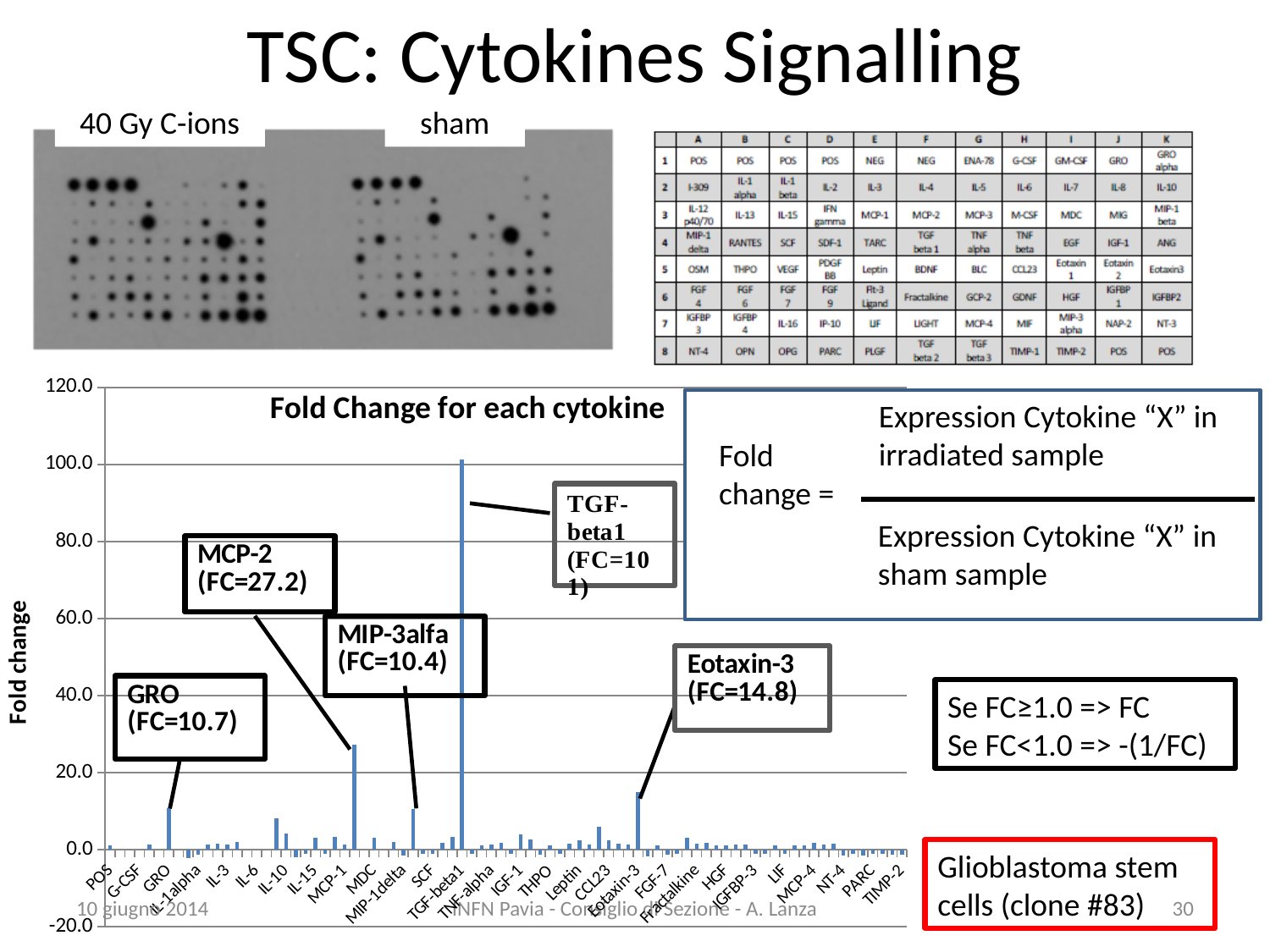
What is the fold change (FC) for Eotaxin-3 according to the callout on the chart? 14.8 What is the fold change (FC) for MCP-2 according to the callout on the chart? 27.2 What is the difference between the fold change of MCP-2 and that of Eotaxin-3? 12.4 What is the label of the vertical axis of the chart? Fold change What is the title of the chart at the bottom of the slide? Fold Change for each cytokine What is the fold change (FC) for MIP-3alfa according to the callout on the chart? 10.4 What is the fold change (FC) for TGF-beta1 according to the callout on the chart? 101 Which cytokine has the highest fold change in the chart? TGF-beta1 What is the fold change (FC) for GRO according to the callout on the chart? 10.7 Is the fold change for MCP-2 greater or less than 20.0? greater What kind of chart is the "Fold Change for each cytokine" chart? bar chart Which has the larger fold change, MCP-2 or Eotaxin-3? MCP-2